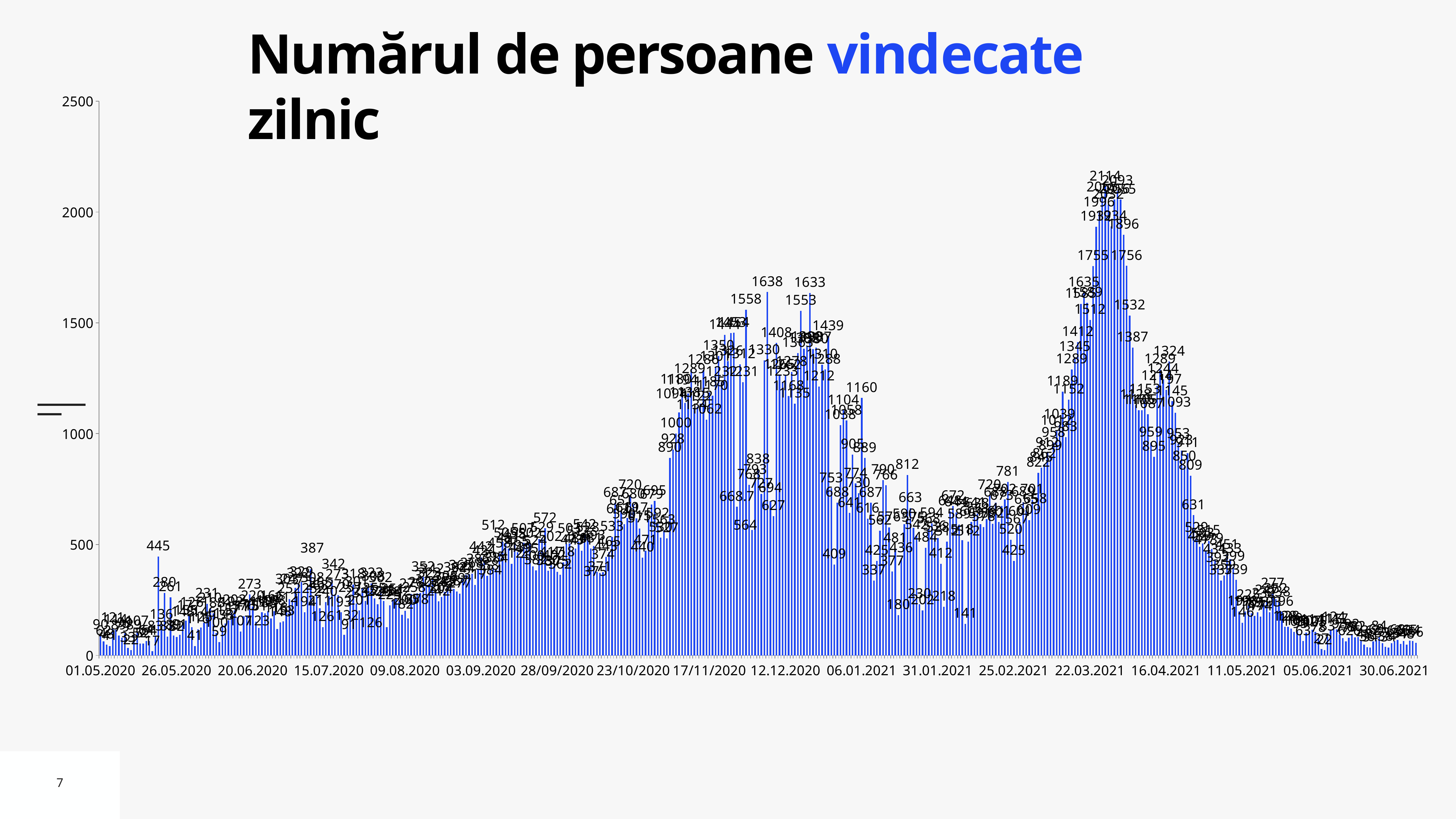
Do the values rise or fall between 22.03.2021 and 30.06.2021? fall What is the highest value shown on the vertical axis? 2500 Which is larger: the peak value around 12.12.2020 (1638) or the peak value around 22.03.2021 (2114)? 2114 Do the values rise or fall between 25.02.2021 and 22.03.2021? rise Is the value for the first bar at 01.05.2020 greater or less than 500? less What is the highest daily value labelled on the chart? 2114 What is the difference between the peak of 2114 in spring 2021 and the peak of 1638 in December 2020? 476 What kind of chart is shown on the slide? bar chart Is the highest value in the period between 01.05.2020 and 09.08.2020 greater or less than 500? less What is the title of the chart? Numărul de persoane vindecate zilnic Is the value for the bar at 30.06.2021 greater or less than 500? less